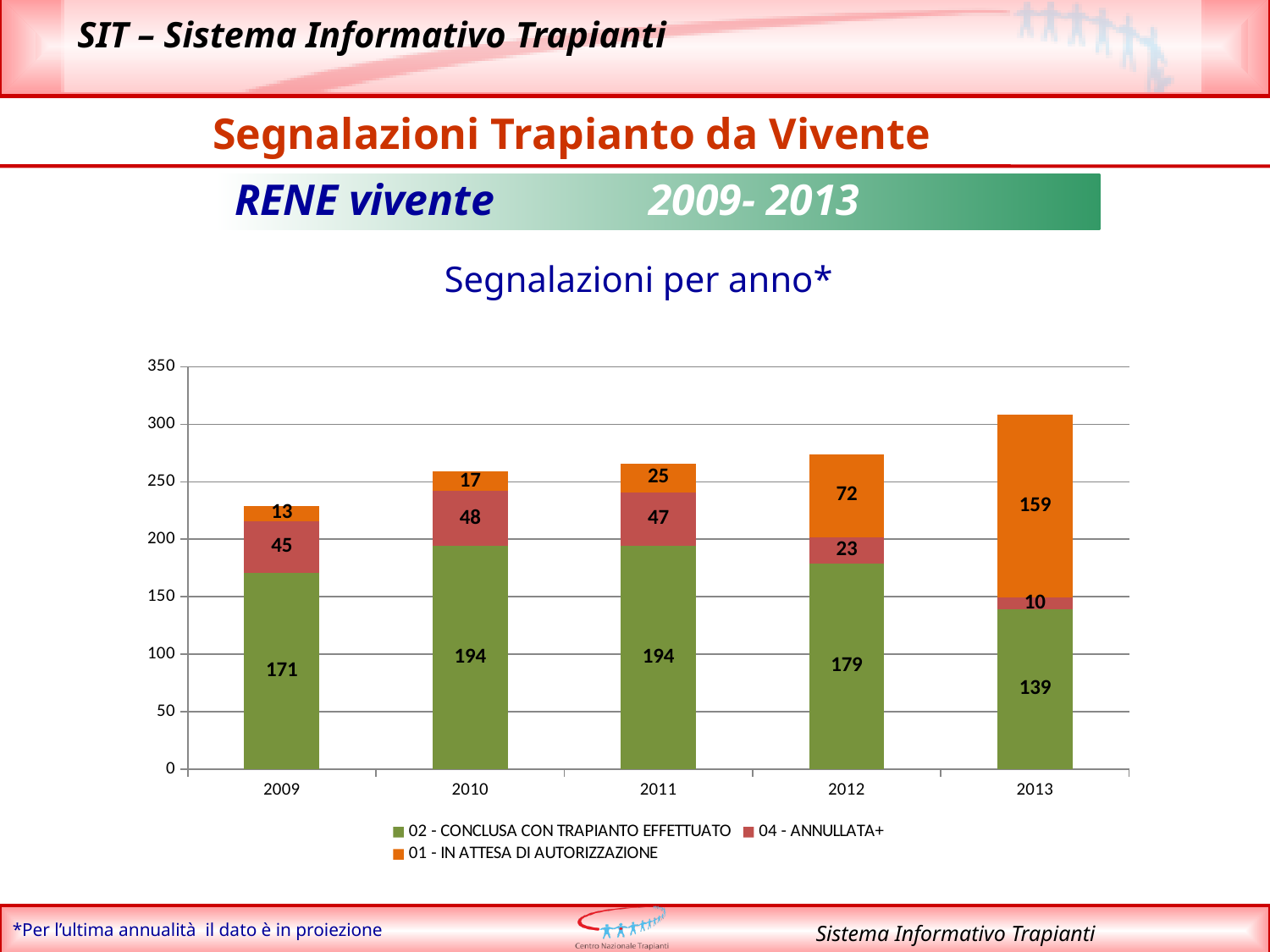
What is the value for "01 - IN ATTESA DI AUTORIZZAZIONE" in 2013? 159 How many series does the legend list? 3 What is the total of the stacked bar for 2009? 229 Which is larger: the "04 - ANNULLATA+" value in 2010 or in 2011? 2010 What is the difference between the "02 - CONCLUSA CON TRAPIANTO EFFETTUATO" values for 2010 and 2013? 55 What is the value for "04 - ANNULLATA+" in 2012? 23 Which year has the highest value for "01 - IN ATTESA DI AUTORIZZAZIONE"? 2013 What is the total of the stacked bar for 2013? 308 What kind of chart is shown on the slide? Stacked bar chart Which year has the lowest value for "02 - CONCLUSA CON TRAPIANTO EFFETTUATO"? 2013 How many years are shown on the x axis? 5 What is the value for "02 - CONCLUSA CON TRAPIANTO EFFETTUATO" in 2009? 171